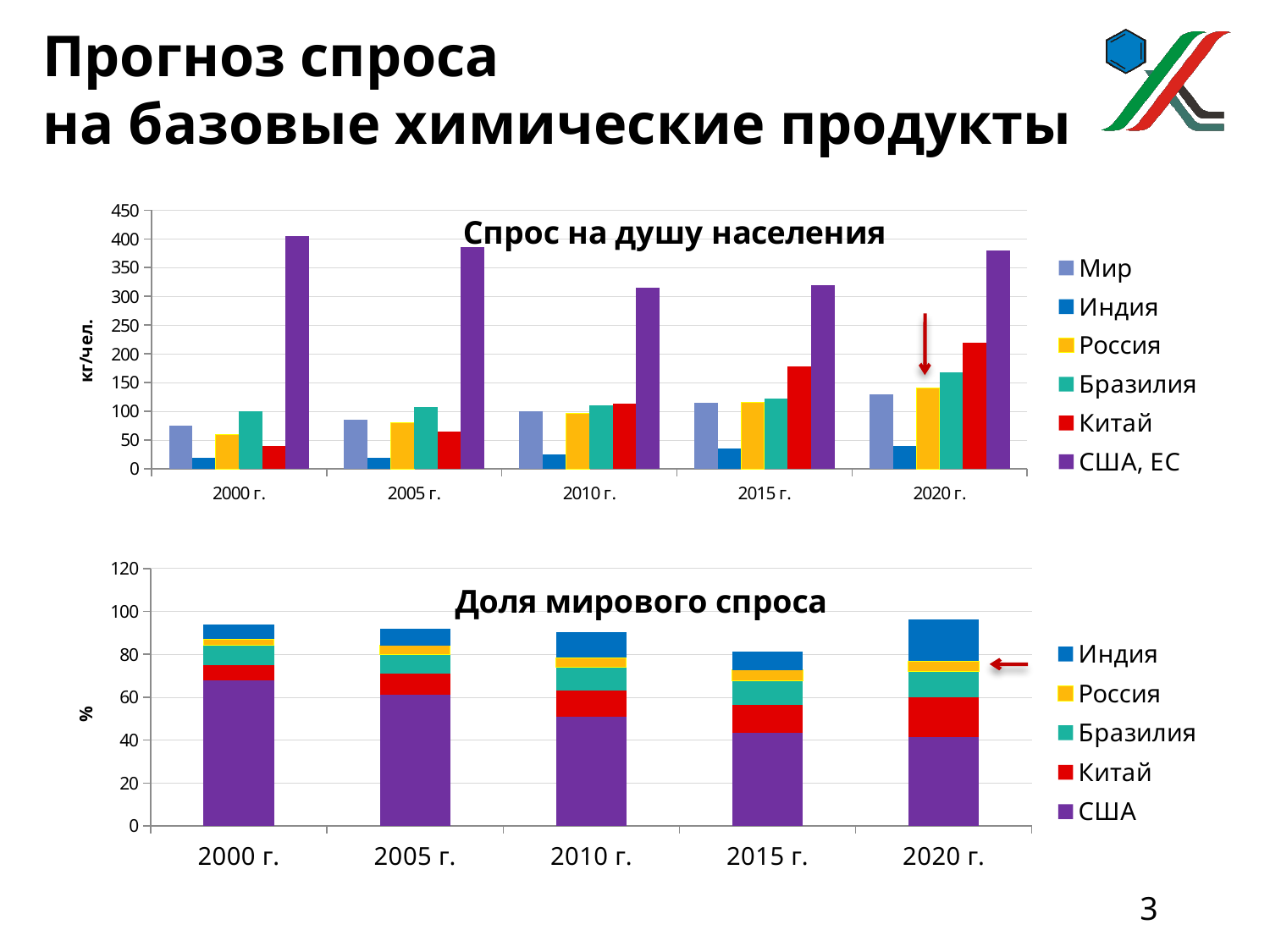
What kind of chart is the 'Спрос на душу населения' chart? bar chart In the 'Доля мирового спроса' chart, does the share for США rise or fall from 2000 г. to 2020 г.? falls In the 'Спрос на душу населения' chart, which is larger in 2020 г.: Китай or Бразилия? Китай In the 'Спрос на душу населения' chart, does the value for Китай rise or fall from 2000 г. to 2020 г.? rises In the 'Спрос на душу населения' chart, which series has the lowest value in 2020 г.? Индия In the 'Спрос на душу населения' chart, which series has the highest value in 2000 г.? США, ЕС What kind of chart is the 'Доля мирового спроса' chart? stacked bar chart How many series does the legend of the 'Доля мирового спроса' chart list? 5 How many year categories are shown on the x axis of the 'Спрос на душу населения' chart? 5 In the 'Спрос на душу населения' chart, is the value for Китай in 2020 г. greater or less than 200? greater In the 'Спрос на душу населения' chart, is the value for Россия in 2000 г. greater or less than 100? less How many series does the legend of the 'Спрос на душу населения' chart list? 6